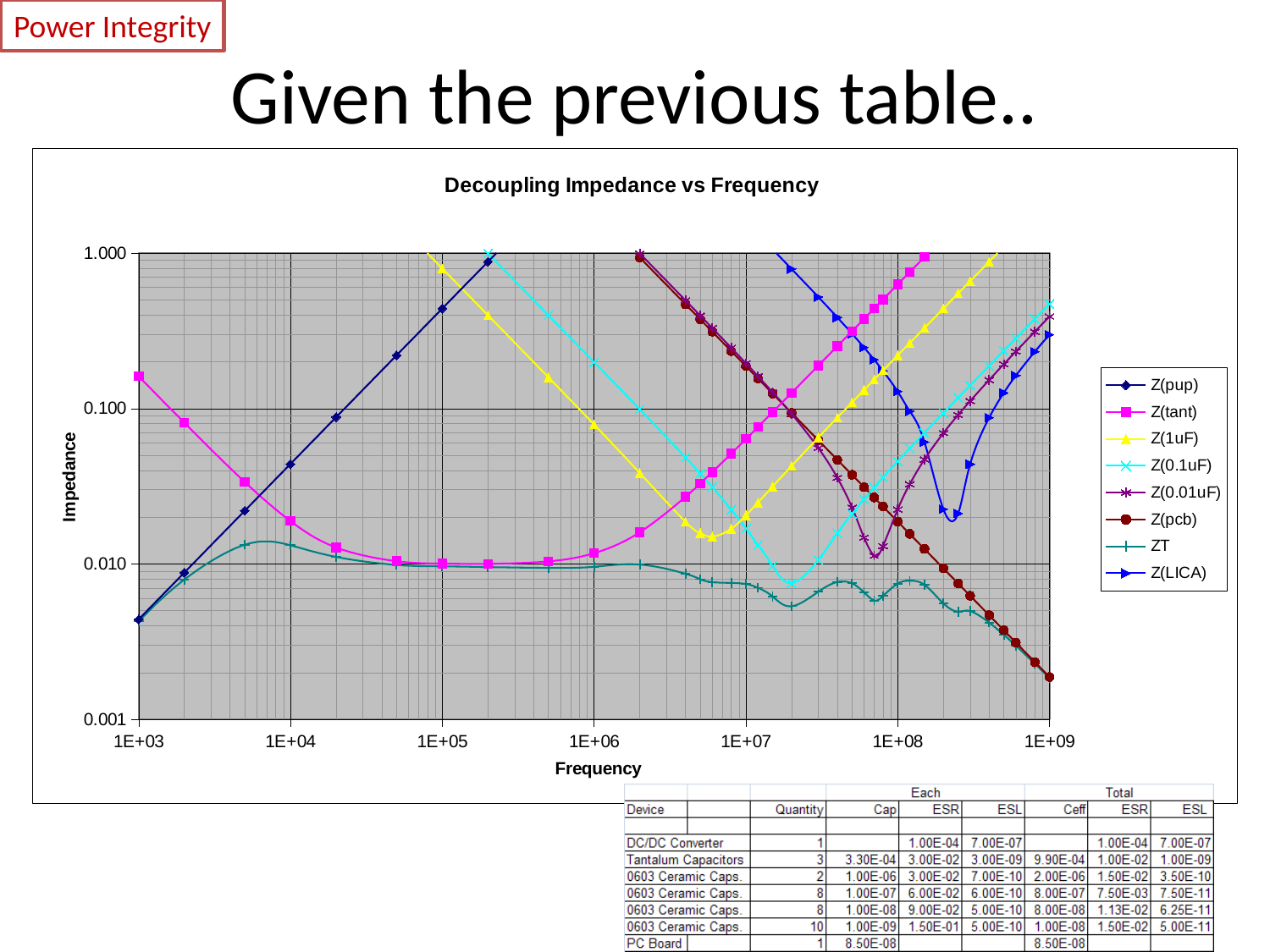
What kind of chart is shown on the slide? line chart Is the value of Z(pup) at 1E+03 greater or less than 0.010? less At 1E+06, which is larger: Z(0.1uF) or Z(tant)? Z(0.1uF) Is the value of Z(tant) at 1E+03 greater or less than 0.100? greater What is the title of the chart? Decoupling Impedance vs Frequency How many series does the chart legend list? 8 Does the Z(pcb) series rise or fall as frequency increases? falls Does the Z(pup) series rise or fall as frequency increases? rises Is the value of Z(0.1uF) at 1E+09 greater or less than 0.100? greater At 1E+03, which is larger: Z(tant) or Z(pup)? Z(tant) What is the label of the vertical axis of the chart? Impedance